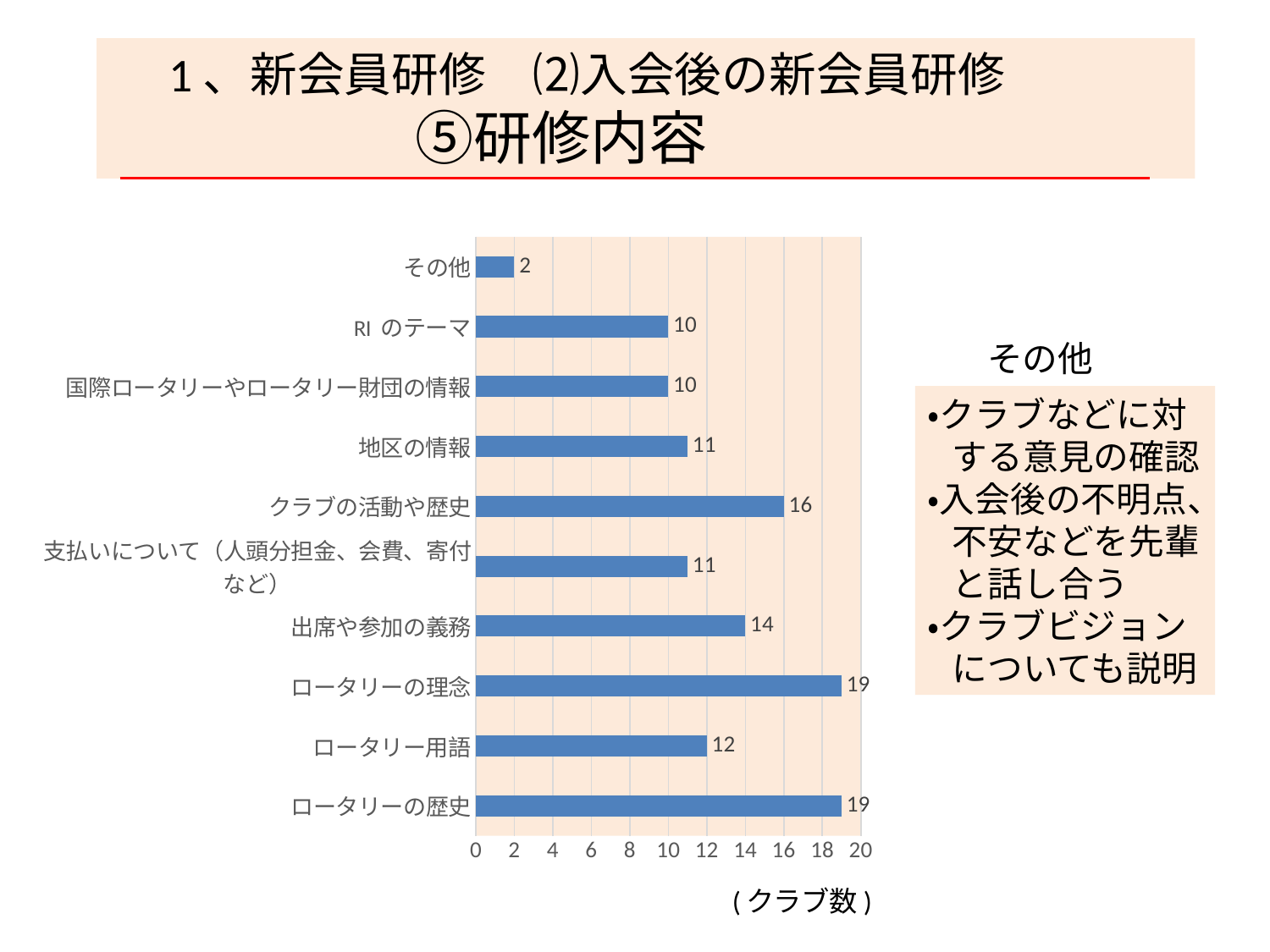
How many categories are shown in the chart? 10 What is the value for ロータリー用語? 12 What is the difference between the values for ロータリーの歴史 and ロータリー用語? 7 What is the value for クラブの活動や歴史? 16 What is the value for ロータリーの理念? 19 Is the value for ロータリーの歴史 greater or less than 18? greater What is the value for 出席や参加の義務? 14 What kind of chart is shown on the slide? bar chart What is the difference between the values for クラブの活動や歴史 and 地区の情報? 5 Which is larger, the value for 出席や参加の義務 or the value for RI のテーマ? 出席や参加の義務 Which category has the lowest value? その他 What unit label is shown below the x axis of the chart? (クラブ数)